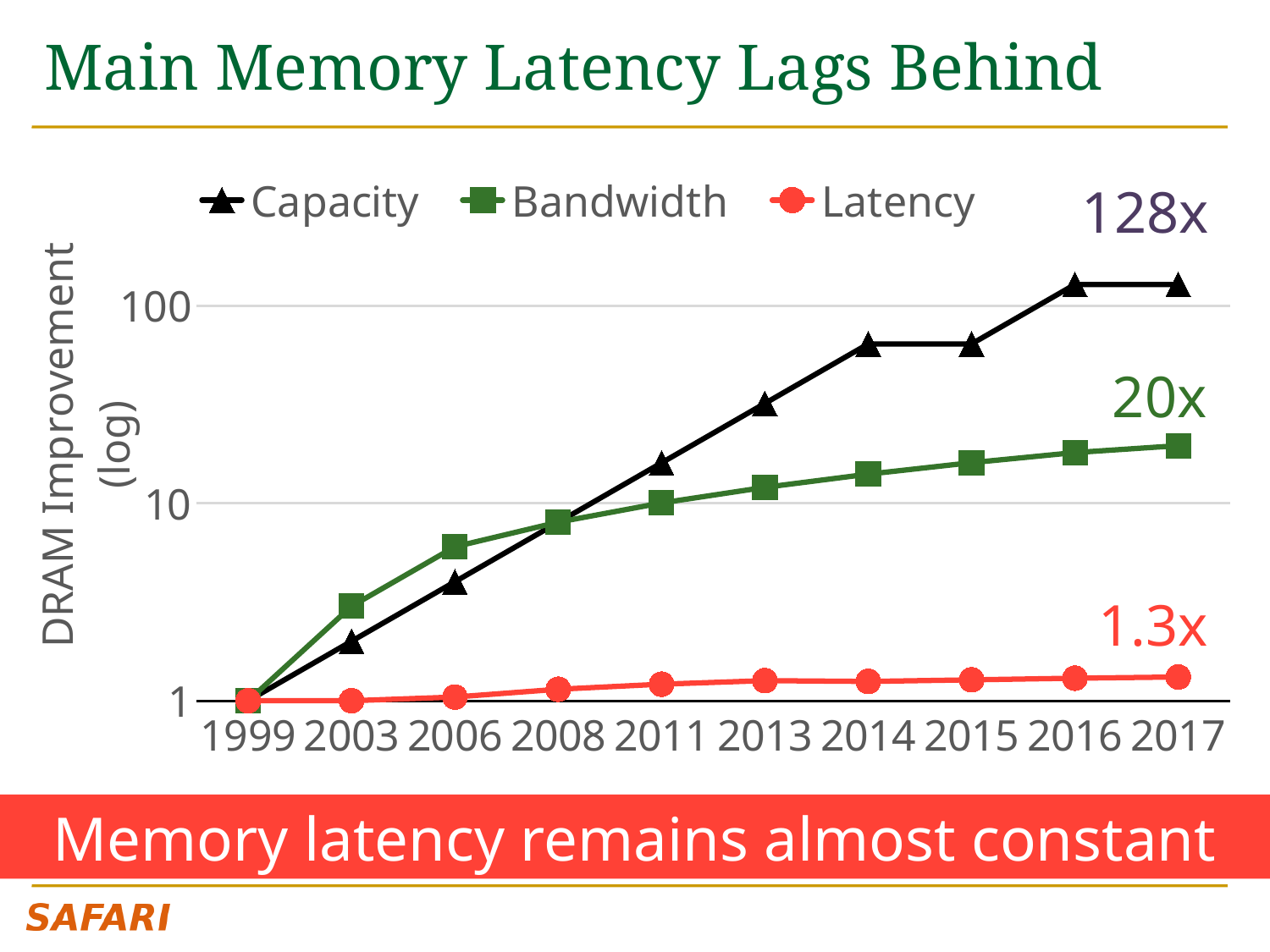
Which series has the highest value in 2017? Capacity How many years are shown on the x axis? 10 What is the DRAM latency improvement in 2017? 1.3x What is the DRAM bandwidth improvement in 2017? 20x Which series has the lowest value in 2017? Latency What is the label on the y axis? DRAM Improvement (log) What kind of chart is shown on the slide? line chart Does the Capacity series rise or fall from 1999 to 2017? rise How many series does the legend list? 3 In 2006, which is larger, Bandwidth or Capacity? Bandwidth Is the Capacity value for 2016 greater or less than 100? greater What is the DRAM capacity improvement in 2017? 128x